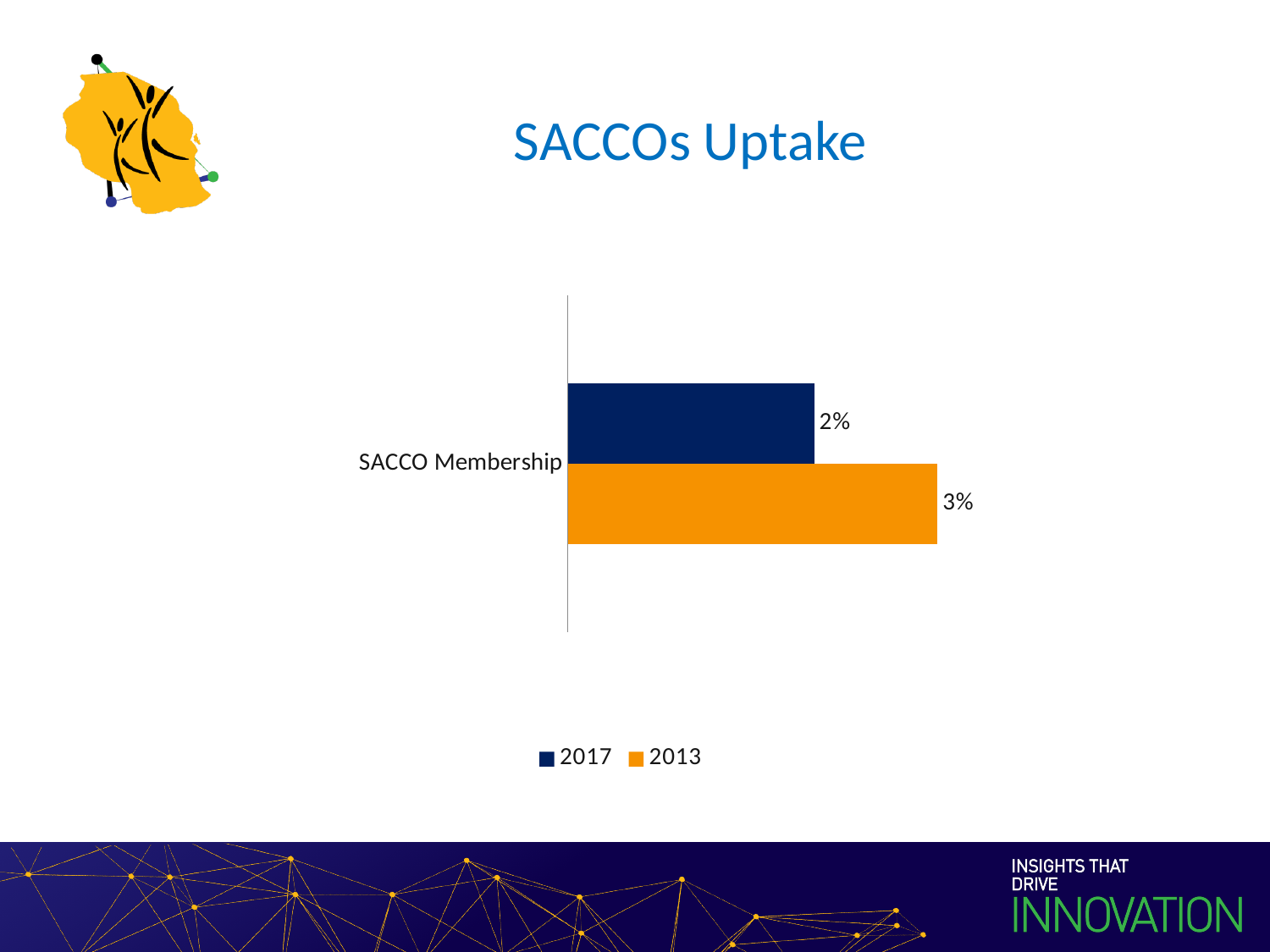
Which year has the higher SACCO Membership value, 2017 or 2013? 2013 What is the title of the slide? SACCOs Uptake What is the category label on the chart? SACCO Membership How many series does the legend list? 2 How many categories are shown on the chart? 1 What kind of chart is shown on the slide? Bar chart What is the difference between the 2013 and 2017 SACCO Membership values? 1% Which series has the lowest value for SACCO Membership? 2017 Which series is shown in orange in the legend? 2013 What is the value for SACCO Membership in 2013? 3% What is the value for SACCO Membership in 2017? 2%